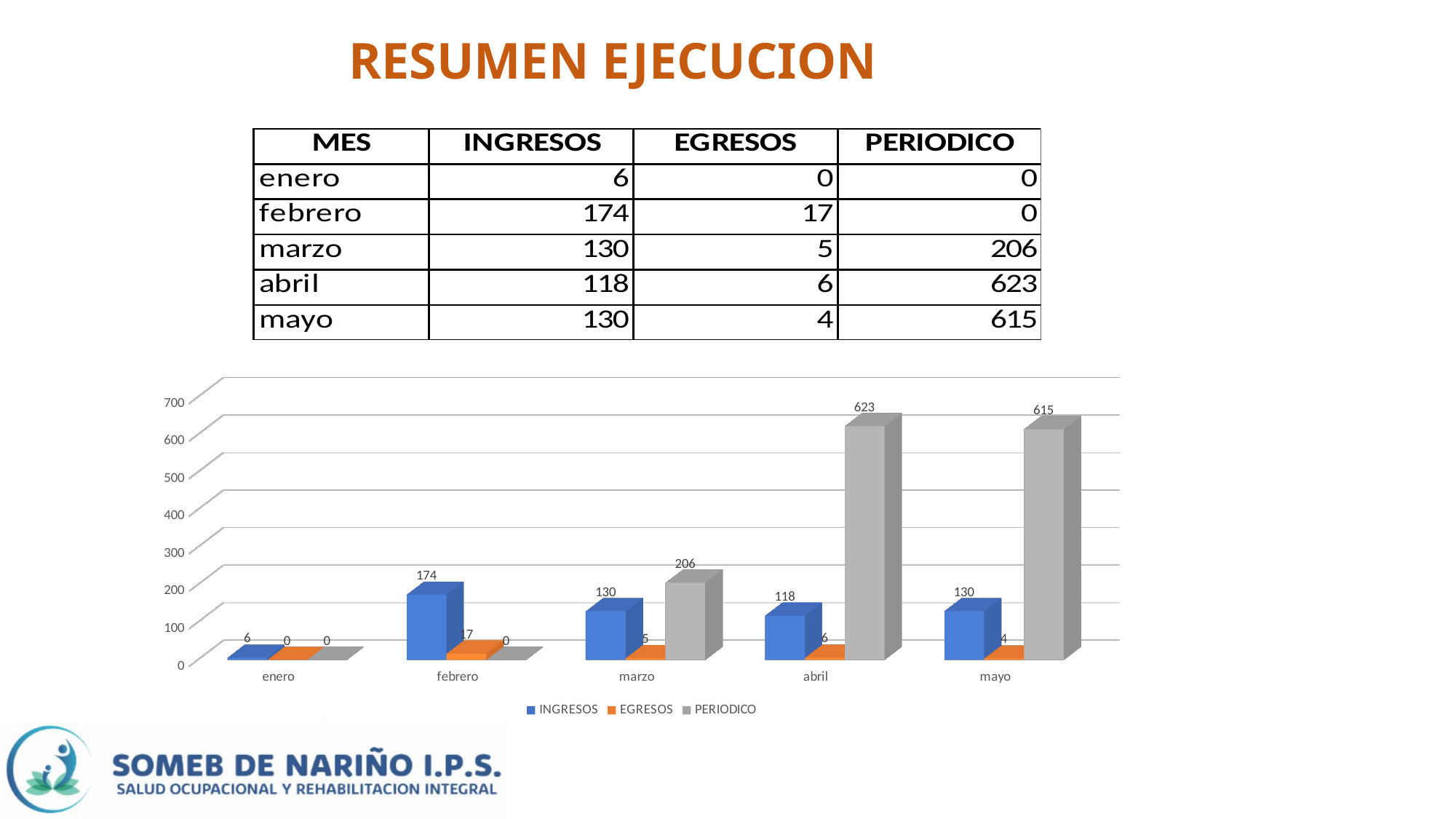
What is the PERIODICO value for abril? 623 Which month has the lowest INGRESOS value? enero What is the INGRESOS value for febrero? 174 Does the PERIODICO series rise or fall from enero to abril? rise Which is larger, the PERIODICO value for marzo or the INGRESOS value for marzo? PERIODICO for marzo What is the EGRESOS value for marzo? 5 What kind of chart is shown on the slide? bar chart What is the difference between the PERIODICO values for abril and mayo? 8 Which colour represents the EGRESOS series in the chart? orange Which month has the highest INGRESOS value? febrero How many series does the chart legend list? 3 How many months are shown on the x axis of the chart? 5